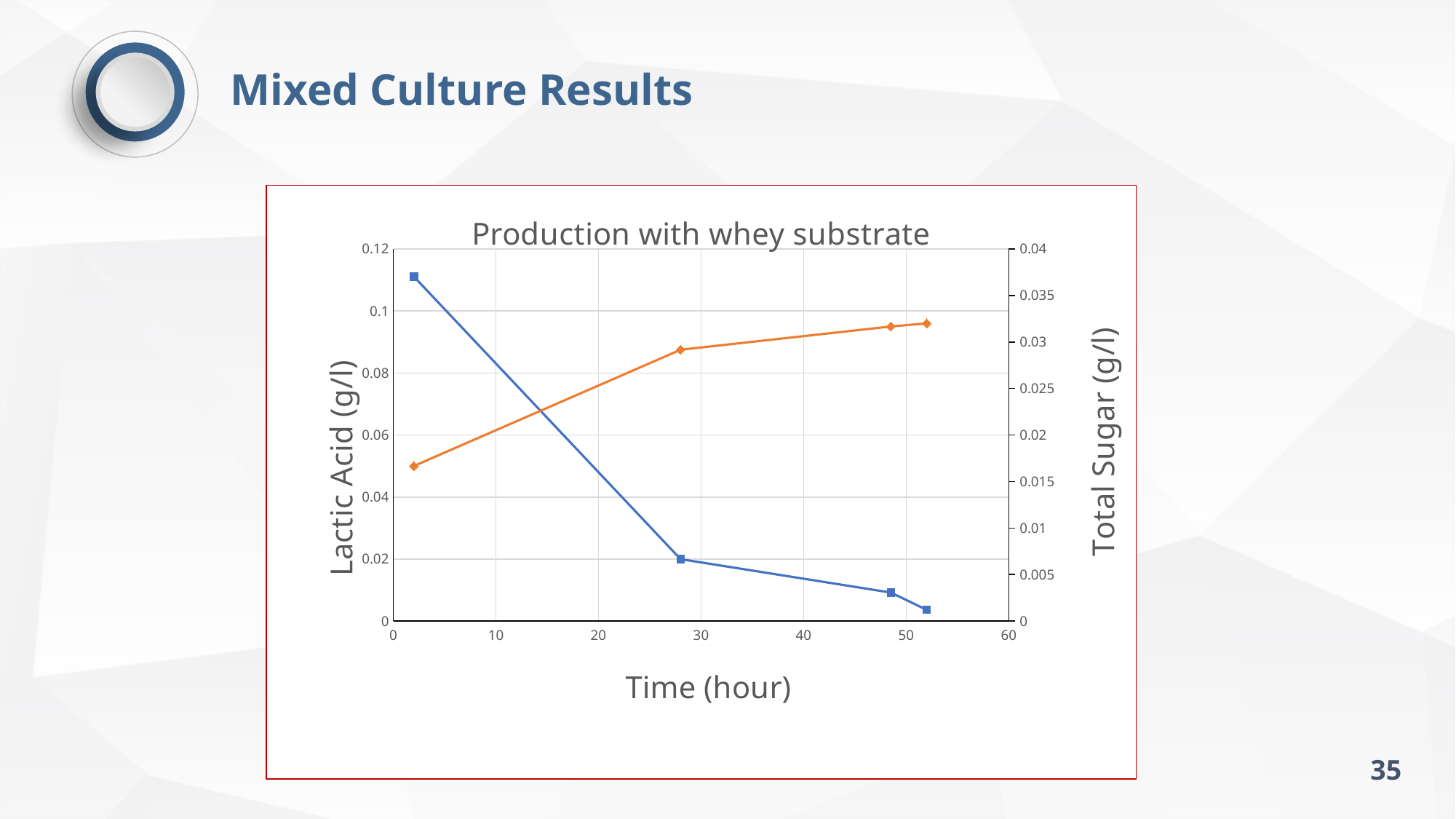
Does the orange line rise or fall as time increases along the x axis? rise How many data points does the blue line with square markers have? 4 What is the title of the chart? Production with whey substrate At around 50 hours, which line is plotted higher on the chart, the blue line or the orange line? orange line Read against the left axis, is the blue line's value at about 28 hours greater or less than 0.04? less Does the blue line rise or fall as time increases along the x axis? fall How many lines (series) are plotted on the chart? 2 What kind of chart is shown on the slide? line chart Read against the left axis, is the orange line's last point (near 52 hours) greater or less than 0.08? greater Read against the left axis, is the first point of the blue line (near 2 hours) greater or less than 0.1? greater How many data points does the orange line with diamond markers have? 4 What is the label of the right-hand vertical axis? Total Sugar (g/l)